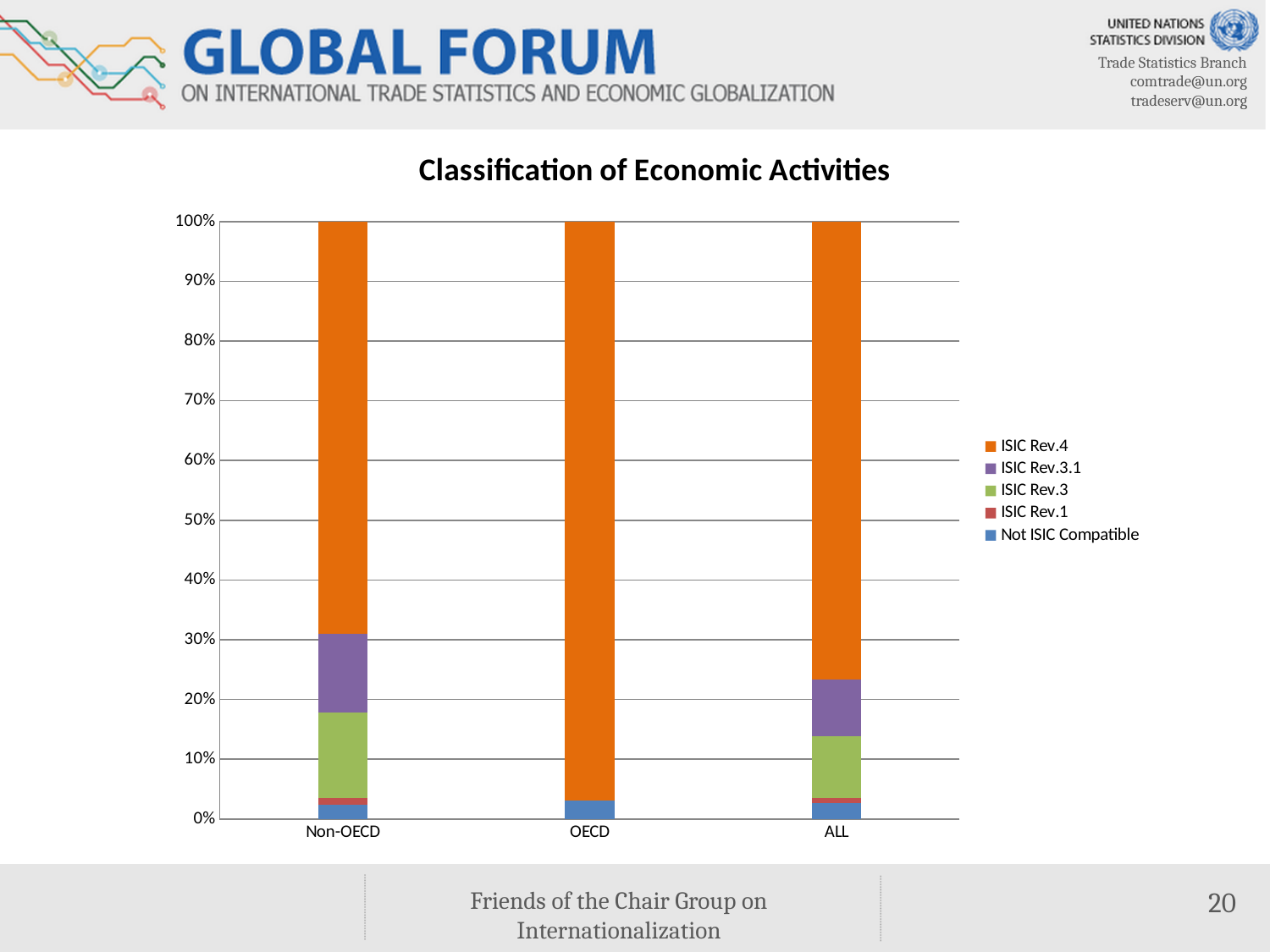
Which category has the largest ISIC Rev.4 share? OECD Is the ISIC Rev.4 share for Non-OECD greater or less than 80%? less Is the ISIC Rev.4 share for OECD greater or less than 90%? greater What is the title of the chart? Classification of Economic Activities How many series does the chart's legend list? 5 Which series is shown in orange in the chart? ISIC Rev.4 How many categories are shown on the x axis of the chart? 3 What kind of chart is shown on the slide? Stacked bar chart What is the total height of the stacked bar for OECD? 100% Is the Not ISIC Compatible share for OECD greater or less than 10%? less Is the ISIC Rev.3 share larger for Non-OECD or for ALL? Non-OECD Which category has the smallest ISIC Rev.4 share? Non-OECD